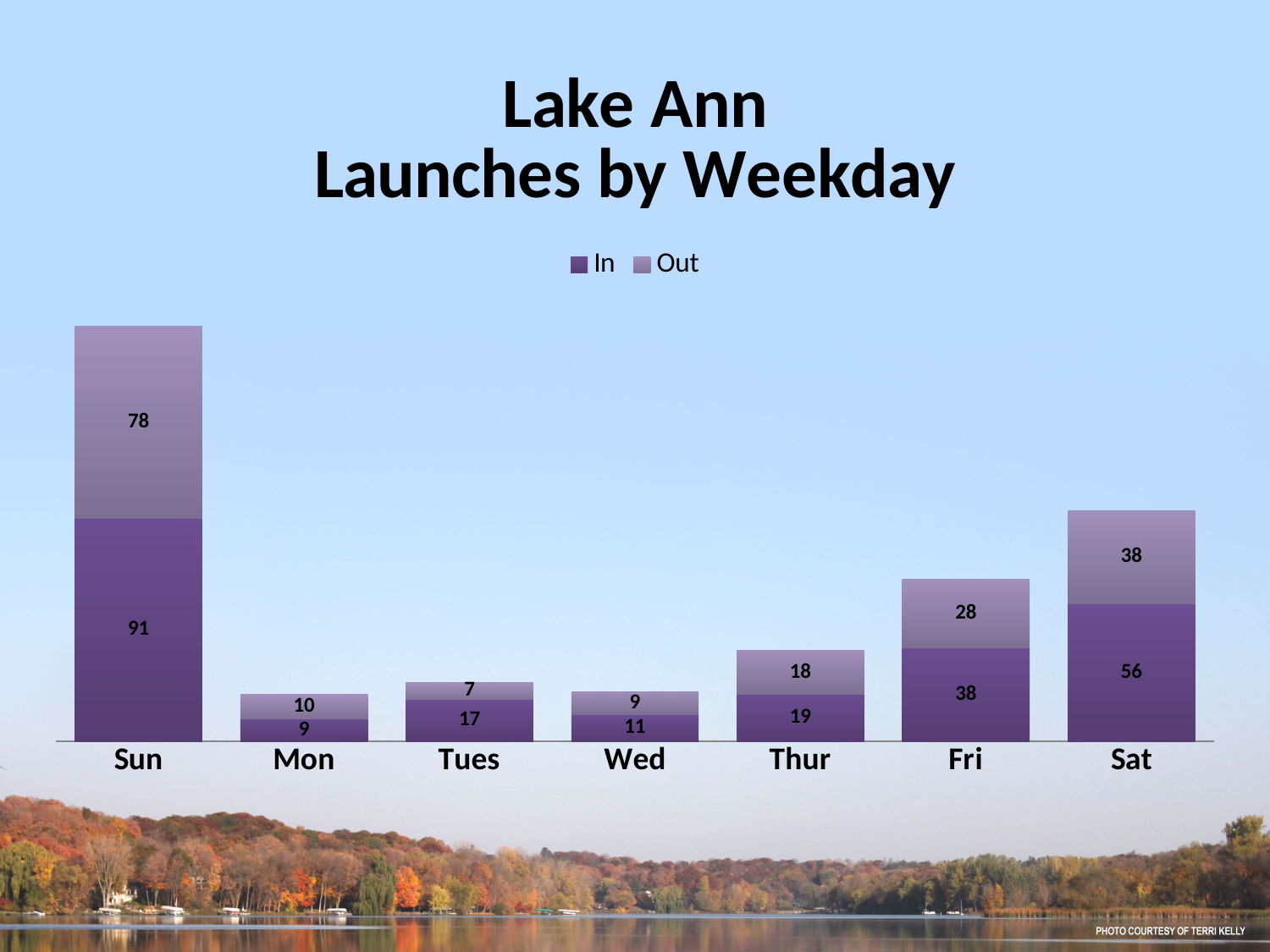
Which weekday has the lowest In value? Mon Which weekday has the highest In value? Sun What is the title of the chart? Lake Ann Launches by Weekday How many weekdays are shown on the x axis? 7 What is the total of the stacked bar for Sat? 94 How many series does the legend list? 2 What is the value of the In series for Sun? 91 Which is larger, the Out value for Sat or the Out value for Thur? Sat What is the difference between the In value for Sat and the In value for Fri? 18 What is the value of the Out series for Fri? 28 What is the value of the Out series for Tues? 7 What kind of chart is shown on the slide? Stacked bar chart